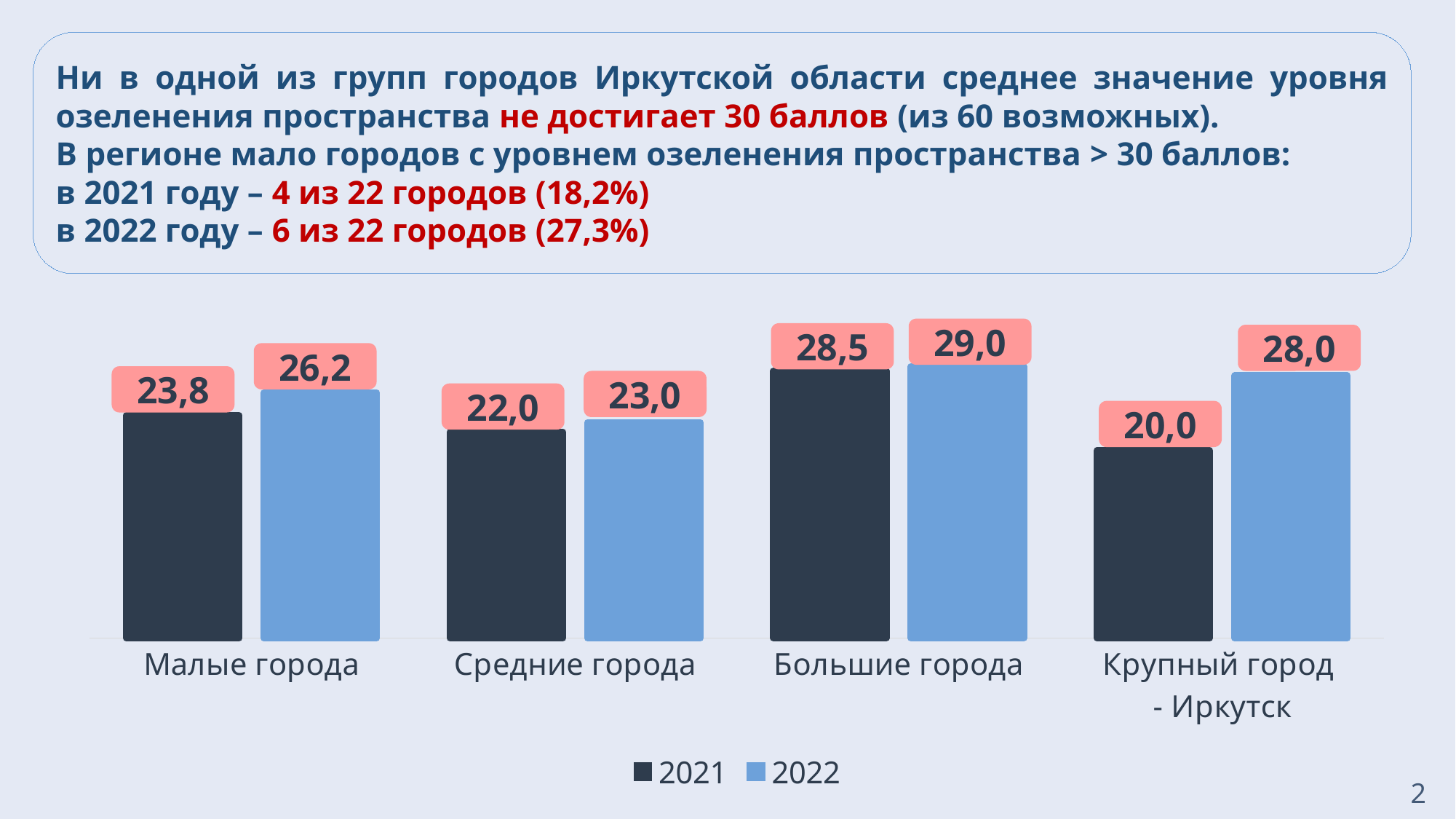
What is the 2021 value for Средние города? 22,0 What is the 2022 value for Малые города? 26,2 Which is larger for Большие города: the 2021 value or the 2022 value? 2022 What is the difference between the 2022 and 2021 values for Крупный город - Иркутск? 8,0 How many series does the legend list? 2 Which category has the lowest 2021 value? Крупный город - Иркутск What is the difference between the 2022 and 2021 values for Малые города? 2,4 What is the 2021 value for Крупный город - Иркутск? 20,0 How many city-group categories are shown on the x axis? 4 Which category has the highest 2022 value? Большие города What kind of chart is shown on the slide? bar chart Which colour represents the 2021 series in the legend? dark navy